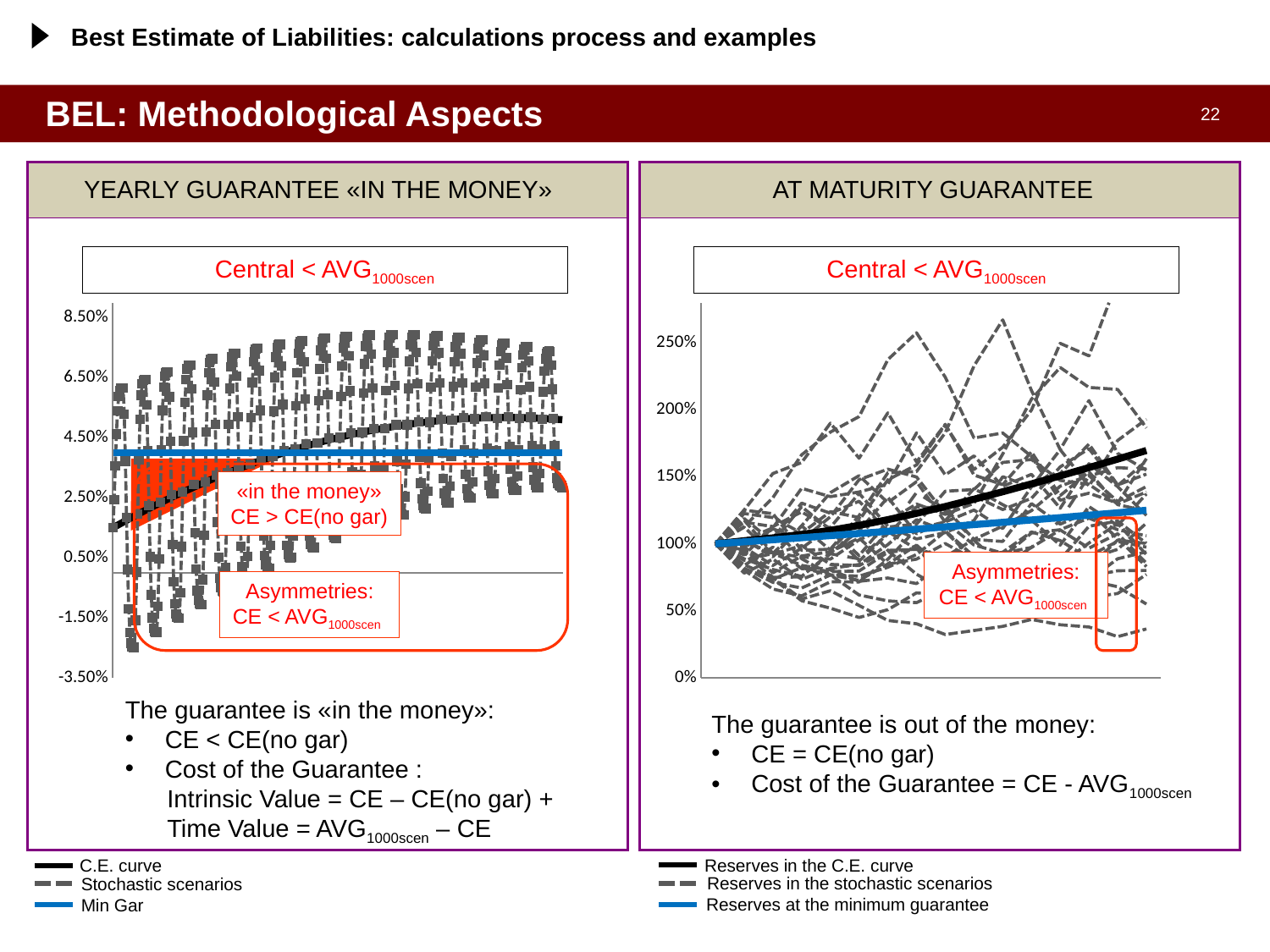
What kind of chart is the AT MATURITY GUARANTEE chart? line chart In the YEARLY GUARANTEE «IN THE MONEY» chart, does the C.E. curve rise or fall along the x axis? rise How many series does the legend of the AT MATURITY GUARANTEE chart list? 3 In the AT MATURITY GUARANTEE chart, does the Reserves in the C.E. curve rise or fall along the x axis? rise In the YEARLY GUARANTEE «IN THE MONEY» chart, what colour is the Min Gar line in the legend? blue In the YEARLY GUARANTEE «IN THE MONEY» chart, is the Min Gar line greater or less than 2.50%? greater In the AT MATURITY GUARANTEE chart, at the right end of the x axis, which is higher: the Reserves in the C.E. curve or the Reserves at the minimum guarantee? Reserves in the C.E. curve What is the highest tick shown on the y axis of the AT MATURITY GUARANTEE chart? 250% In the AT MATURITY GUARANTEE chart, is the final value of the Reserves in the C.E. curve greater or less than 150%? greater In the AT MATURITY GUARANTEE chart, is the final value of the Reserves at the minimum guarantee line greater or less than 150%? less What kind of chart is the YEARLY GUARANTEE «IN THE MONEY» chart? line chart How many series does the legend of the YEARLY GUARANTEE «IN THE MONEY» chart list? 3